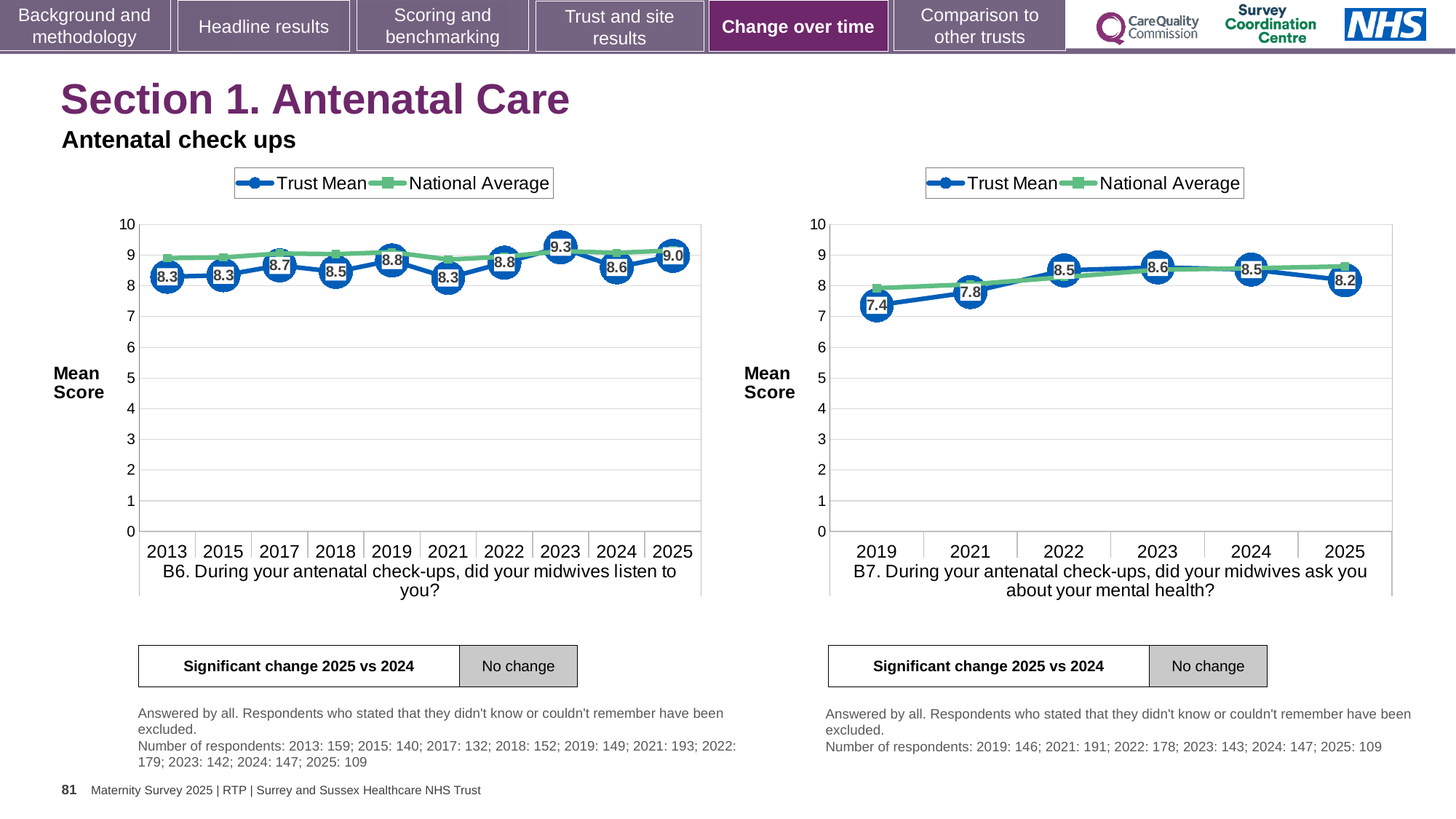
How many years are shown on the x axis of the left chart (B6)? 10 In the left chart (B6), what is the Trust Mean for 2023? 9.3 How many series does the legend of the right chart (B7) list? 2 In the right chart (B7), is the National Average for 2019 greater or less than 7? greater In the right chart (B7), what is the Trust Mean for 2019? 7.4 In the right chart (B7), what is the Trust Mean for 2025? 8.2 In the left chart (B6), what is the Trust Mean for 2025? 9.0 In the right chart (B7), which year has the lowest Trust Mean? 2019 In the left chart (B6), which is larger, the Trust Mean for 2021 or the Trust Mean for 2022? 2022 In the left chart (B6), which year has the highest Trust Mean? 2023 In the right chart (B7), what is the difference between the Trust Mean for 2023 and the Trust Mean for 2019? 1.2 What kind of chart is the left chart (B6)? Line chart